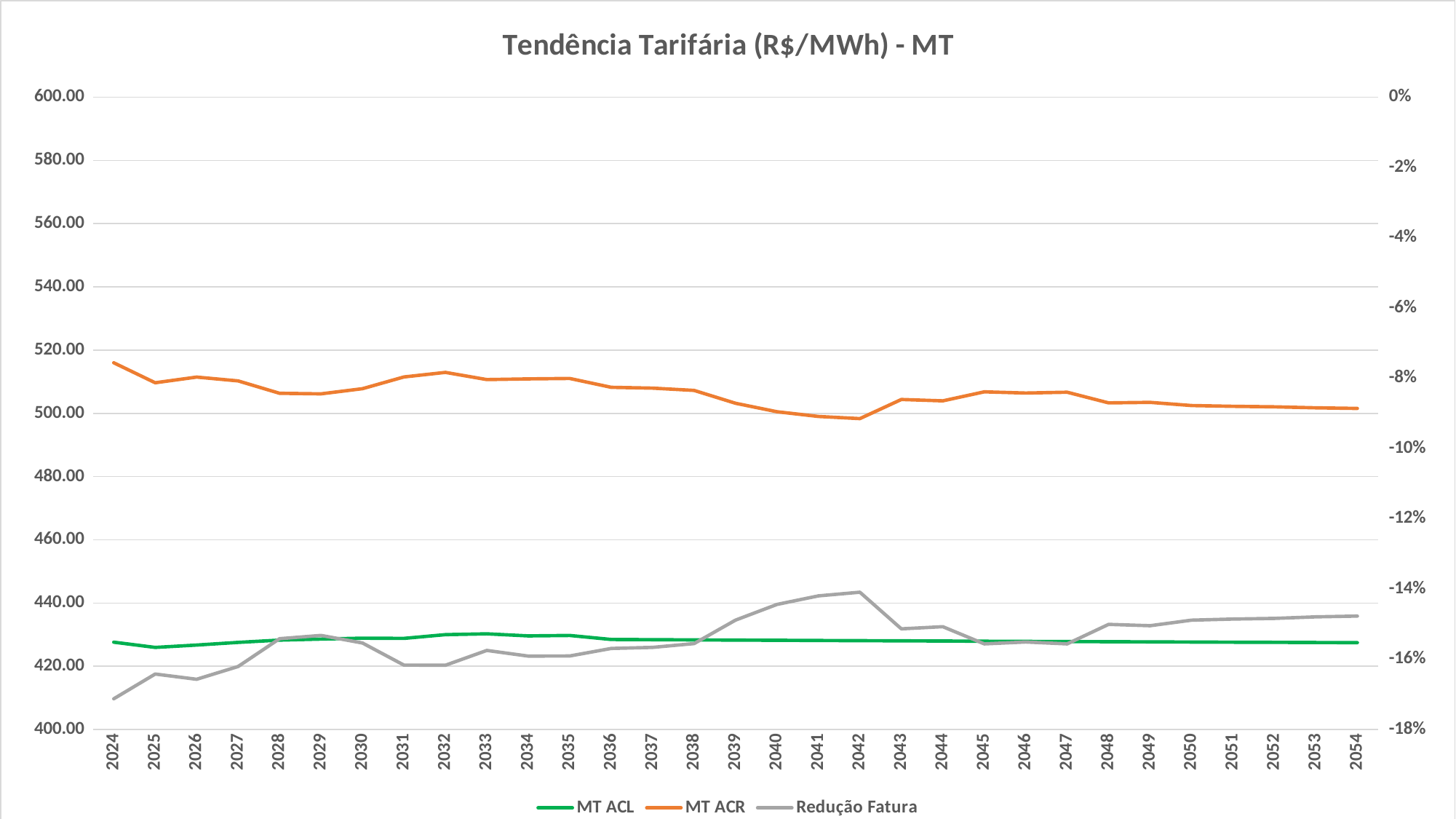
Is the value for MT ACL in 2024 greater or less than 440.00? less How many series does the legend list? 3 Is the value for MT ACR in 2024 greater or less than 500.00? greater What is the title of the chart? Tendência Tarifária (R$/MWh) - MT Does the MT ACR series rise or fall overall from 2024 to 2054? fall What kind of chart is shown on the slide? line chart In which year does the Redução Fatura series reach its highest value? 2042 How many years are plotted along the x axis? 31 Which is larger in 2030, MT ACR or MT ACL? MT ACR Is the value for MT ACR in 2040 greater or less than 520.00? less What colour is the MT ACL line? green